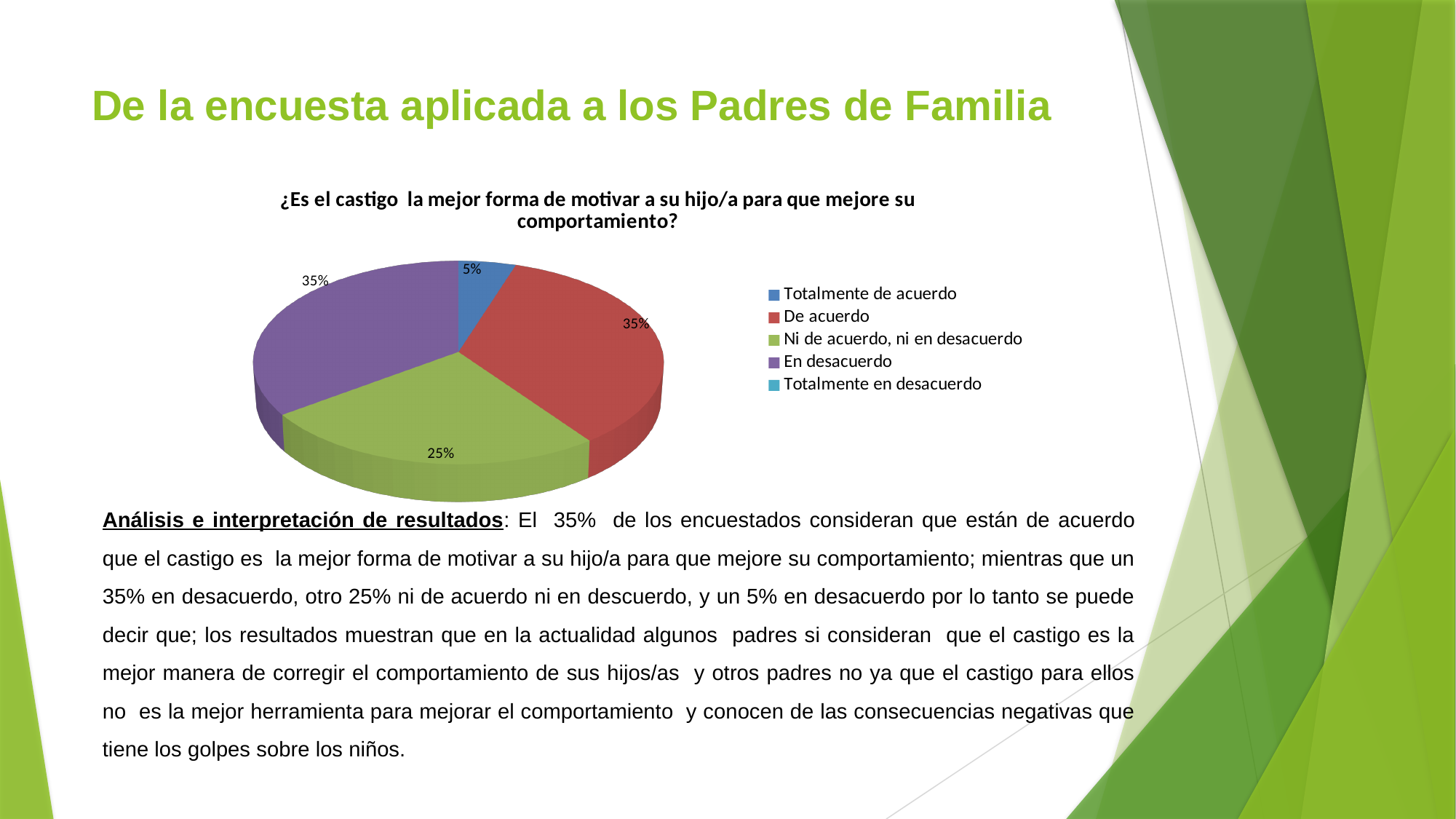
What is the difference in percentage points between "De acuerdo" and "Totalmente de acuerdo"? 30 percentage points What percentage of respondents answered "De acuerdo"? 35% Which is larger, the share for "De acuerdo" or the share for "Ni de acuerdo, ni en desacuerdo"? De acuerdo What is the difference in percentage points between "En desacuerdo" and "Ni de acuerdo, ni en desacuerdo"? 10 percentage points What percentage of respondents answered "Totalmente de acuerdo"? 5% How many entries does the chart legend list? 5 How many slices with data labels are visible in the pie chart? 4 What colour represents "En desacuerdo" in the pie chart? Purple What percentage of respondents answered "En desacuerdo"? 35% What percentage of respondents answered "Ni de acuerdo, ni en desacuerdo"? 25% What type of chart is shown on the slide? Pie chart Which is larger, the share for "En desacuerdo" or the share for "Totalmente de acuerdo"? En desacuerdo